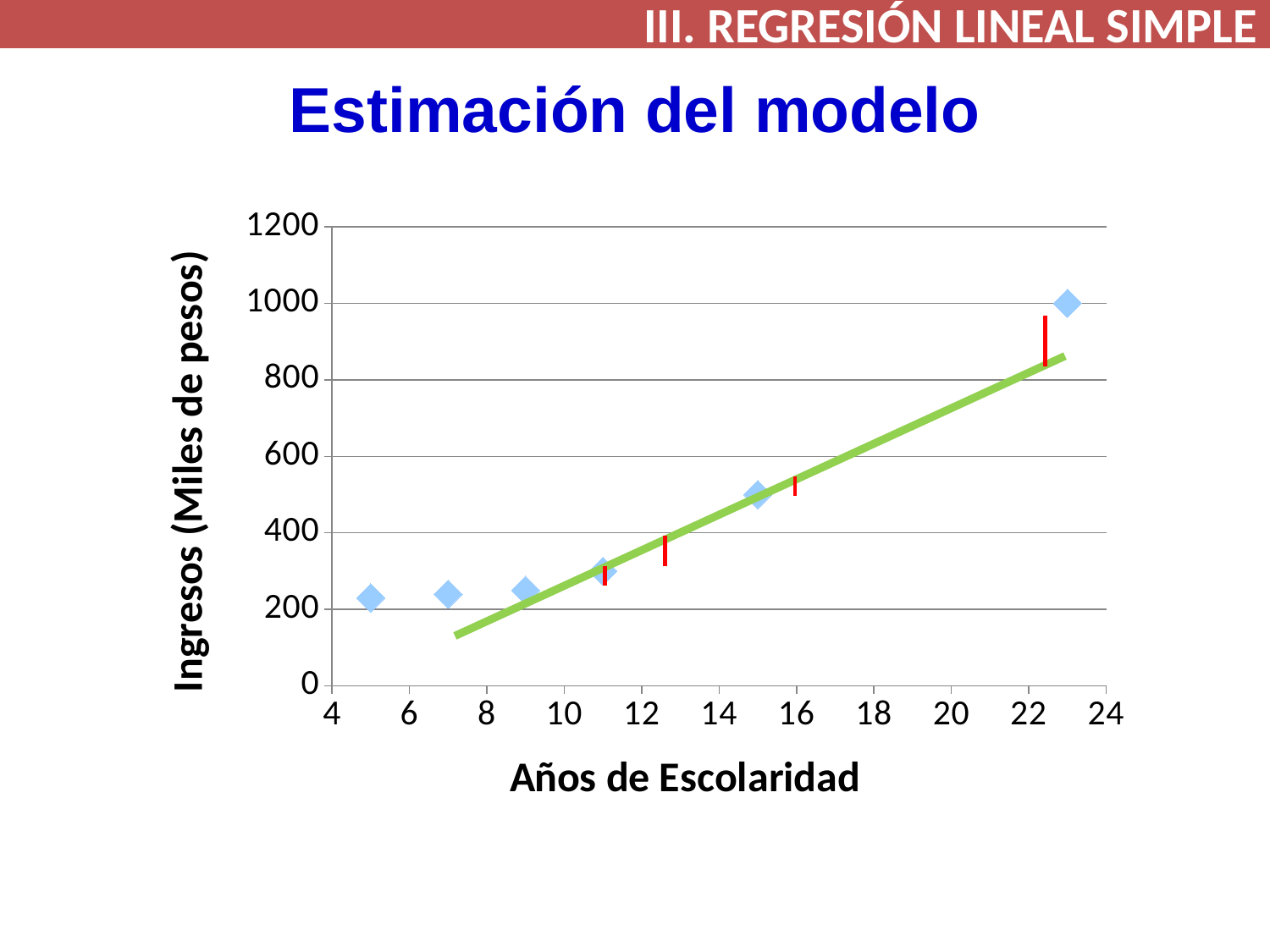
What kind of chart is shown on the slide? scatter chart What is the title of the chart's y axis? Ingresos (Miles de pesos) Is the income value for the point at 23 years of schooling greater or less than 800? greater Is the income value for the point at 5 years of schooling greater or less than 400? less How many data points are plotted in the chart? 6 Do the income values generally rise or fall as years of schooling increase? rise What is the title of the chart's x axis? Años de Escolaridad Is the income value for the point at 15 years of schooling greater or less than 600? less Which point has a larger income value: the one at 15 years of schooling or the one at 9 years of schooling? 15 years of schooling Which data point has the highest income value (Ingresos)? the point at 23 years of schooling What is the maximum value shown on the y axis? 1200